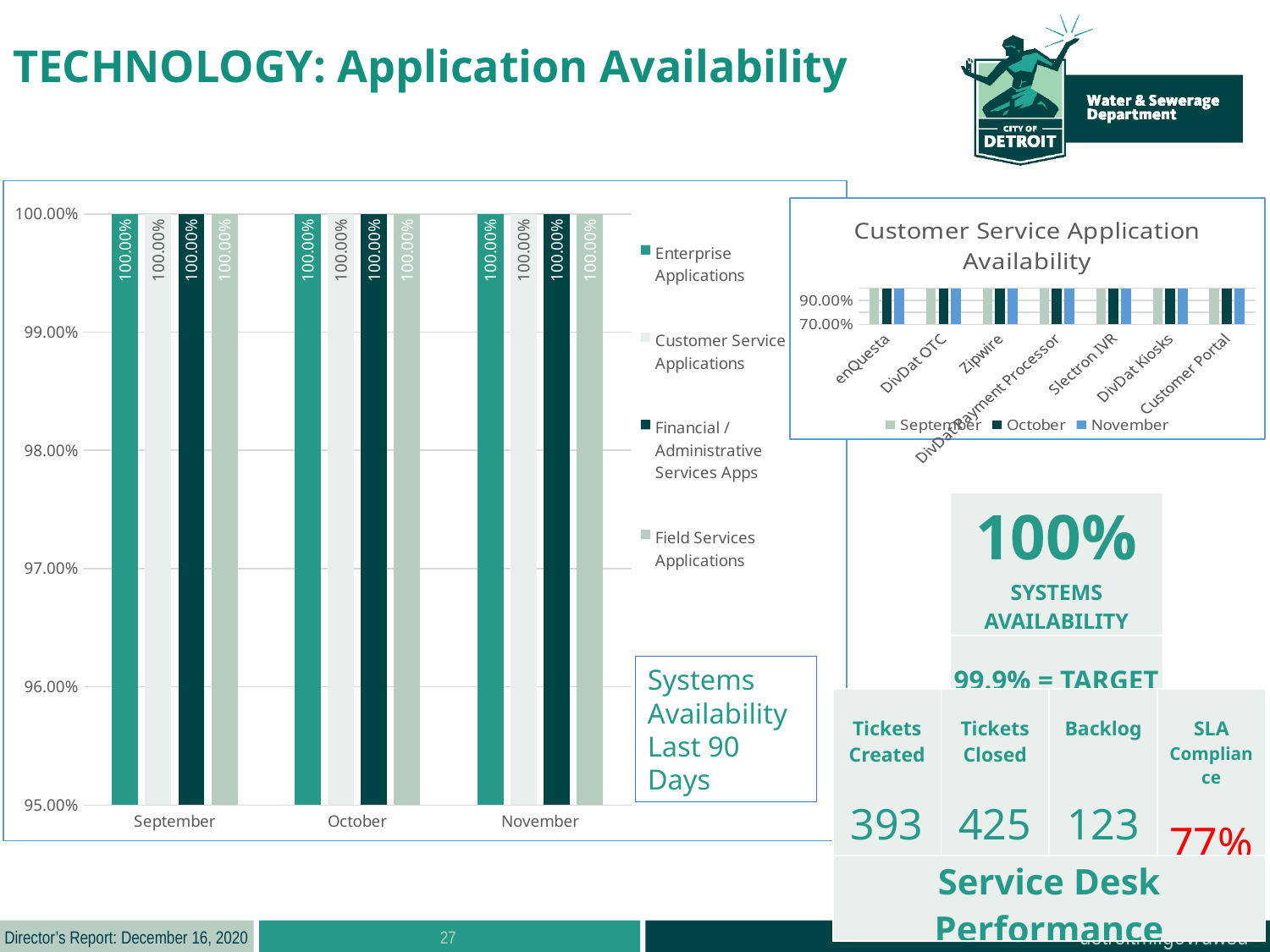
In the large chart on the left (Systems Availability Last 90 Days), do the Enterprise Applications values rise, fall, or stay the same from September to November? Stay the same In the chart titled Customer Service Application Availability, is the September value for enQuesta greater or less than 70.00%? greater In the large chart on the left (Systems Availability Last 90 Days), what is the difference between the Enterprise Applications value in September and the Customer Service Applications value in November? 0.00% In the large chart on the left (Systems Availability Last 90 Days), what is the value for Enterprise Applications in September? 100.00% In the chart titled Customer Service Application Availability, how many series does the legend list? 3 In the chart titled Customer Service Application Availability, which series is shown in blue in the legend? November In the large chart on the left (Systems Availability Last 90 Days), what is the value for Field Services Applications in November? 100.00% What kind of chart is the large chart on the left (Systems Availability Last 90 Days)? Bar chart In the chart titled Customer Service Application Availability, how many applications are shown on the x axis? 7 In the large chart on the left (Systems Availability Last 90 Days), how many months are shown on the x axis? 3 In the large chart on the left (Systems Availability Last 90 Days), what is the value for Financial / Administrative Services Apps in October? 100.00% In the large chart on the left (Systems Availability Last 90 Days), how many series does the legend list? 4